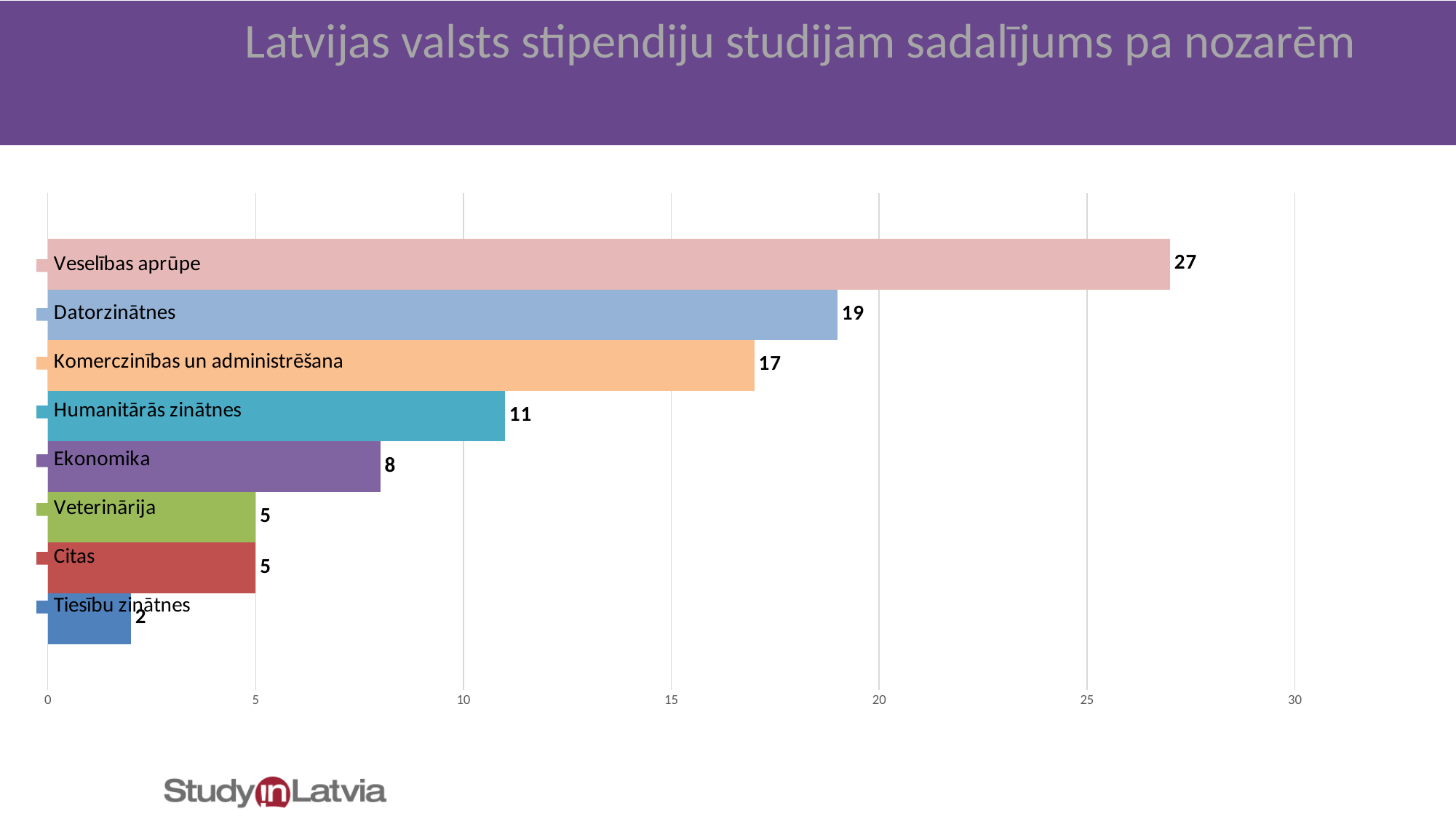
What kind of chart is shown on the slide? bar chart Which category has the highest value? Veselības aprūpe How many categories are shown in the chart? 8 What is the difference between the values for Veselības aprūpe and Datorzinātnes? 8 What is the value for Veselības aprūpe? 27 What is the value for Tiesību zinātnes? 2 Which is larger, the value for Ekonomika or the value for Humanitārās zinātnes? Humanitārās zinātnes What is the value for Komerczinības un administrēšana? 17 Which category has the lowest value? Tiesību zinātnes What is the value for Datorzinātnes? 19 What is the title of the slide? Latvijas valsts stipendiju studijām sadalījums pa nozarēm What is the value for Humanitārās zinātnes? 11